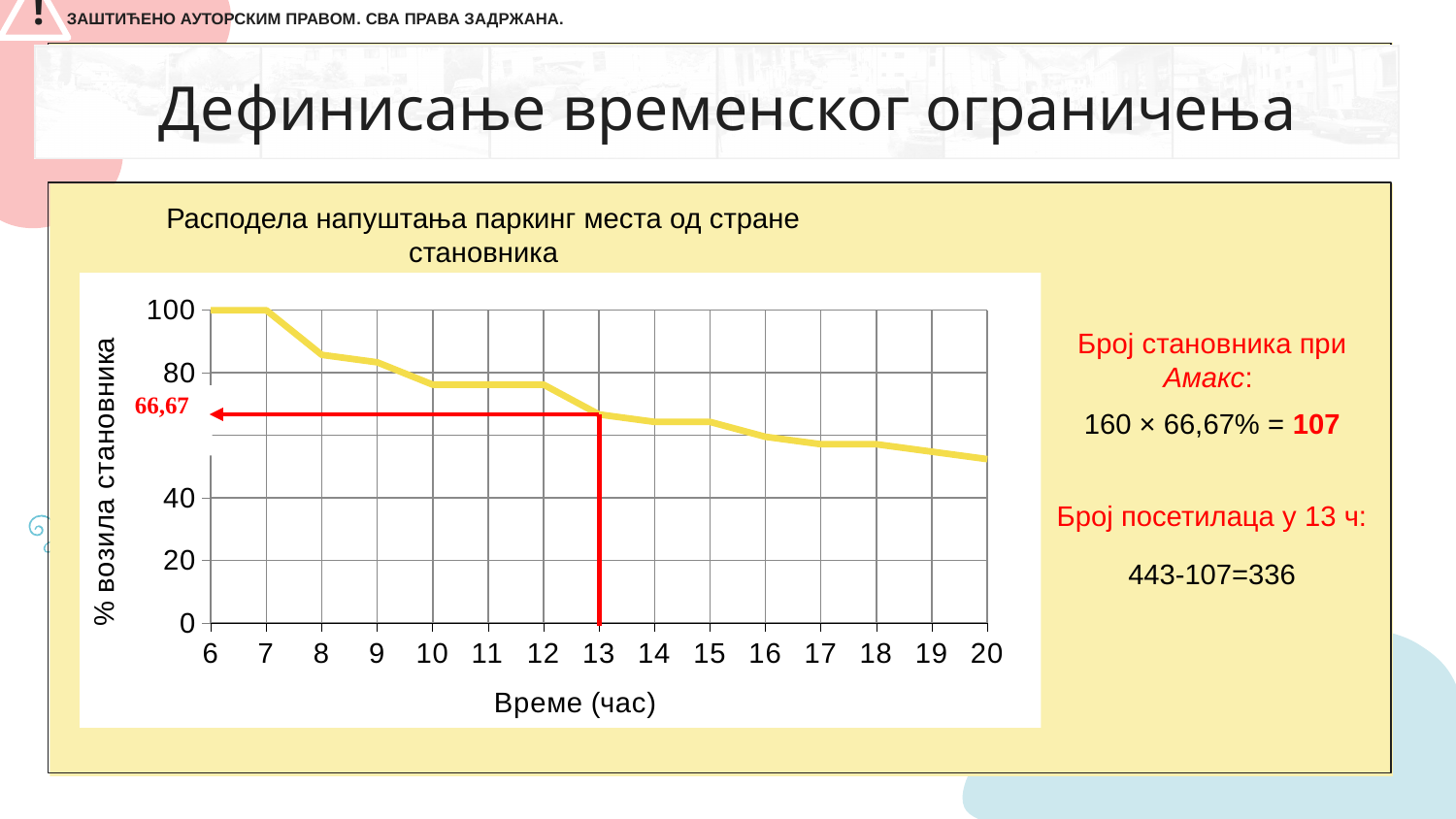
At which hour is the value lowest? 20 What is the title of the x axis? Време (час) Which is larger, the value at 8 hours or the value at 16 hours? 8 hours What is the value of % возила становника at 13 hours? 66,67 Is the value at 8 hours greater or less than 80? greater Do the values rise or fall as time increases along the x axis? fall What is the value of % возила становника at 6 hours? 100 How many hour points are marked on the x axis? 15 What kind of chart is shown on the slide? line chart Is the value at 10 hours greater or less than 80? less What is the difference between the value at 6 hours and the value at 13 hours? 33,33 Is the value at 20 hours greater or less than 60? less